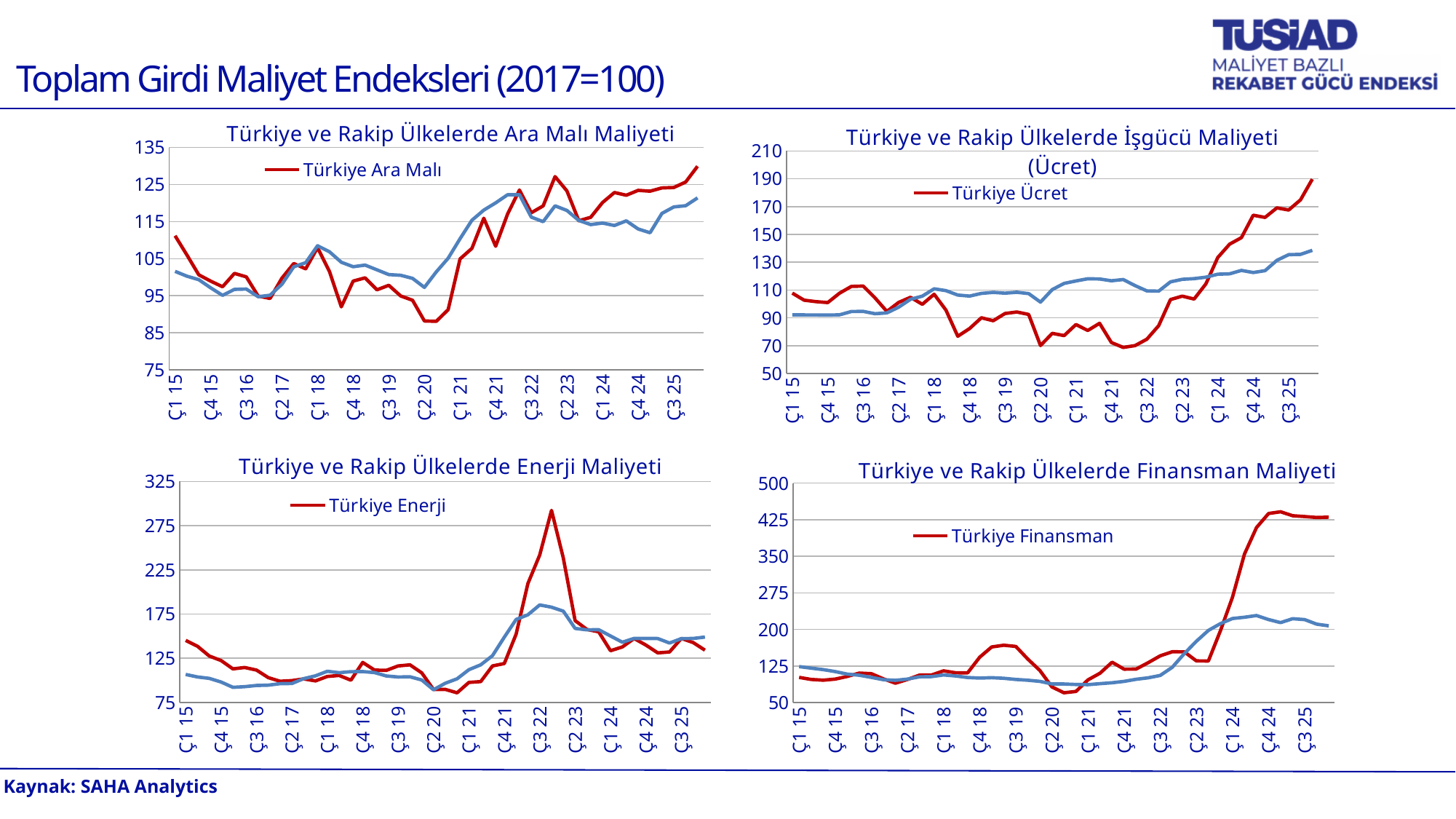
In the "Türkiye ve Rakip Ülkelerde Finansman Maliyeti" chart, is the value of Türkiye Finansman at Ç4 24 greater or less than 350? greater What kind of chart is "Türkiye ve Rakip Ülkelerde Ara Malı Maliyeti"? Line chart In the "Türkiye ve Rakip Ülkelerde Finansman Maliyeti" chart, does the Türkiye Finansman line rise or fall between Ç3 22 and Ç4 24? Rise What series name is shown in the legend of the "Türkiye ve Rakip Ülkelerde Enerji Maliyeti" chart? Türkiye Enerji In the "Türkiye ve Rakip Ülkelerde Ara Malı Maliyeti" chart, is the value of Türkiye Ara Malı at Ç2 20 greater or less than 95? less What colour is the Türkiye Finansman line in the "Türkiye ve Rakip Ülkelerde Finansman Maliyeti" chart? Red In the "Türkiye ve Rakip Ülkelerde İşgücü Maliyeti (Ücret)" chart, is the value of Türkiye Ücret at Ç2 20 greater or less than 90? less In the "Türkiye ve Rakip Ülkelerde İşgücü Maliyeti (Ücret)" chart, does the Türkiye Ücret line rise or fall from Ç3 22 to the end of the series? Rise